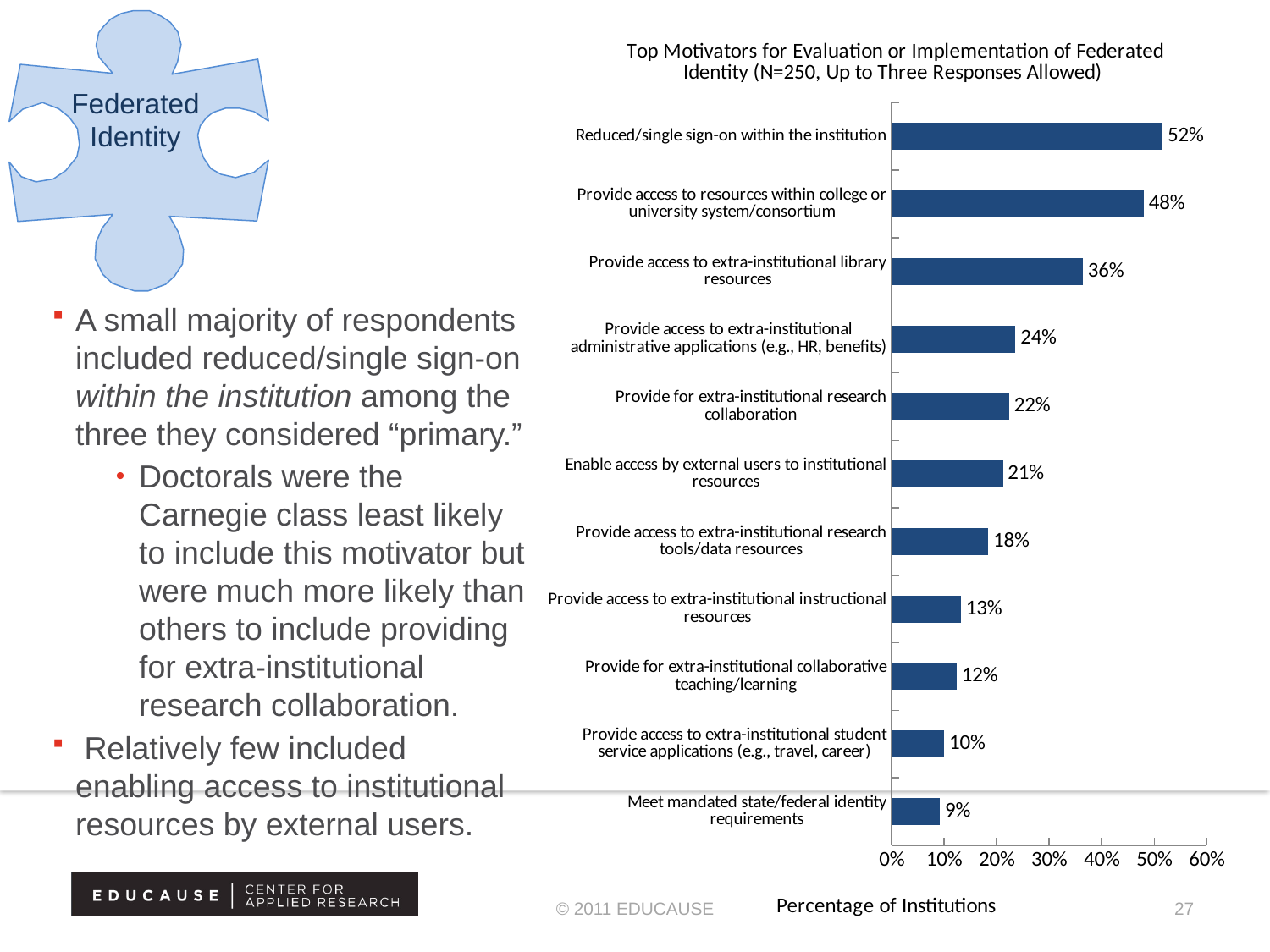
Which motivator has the highest percentage of institutions? Reduced/single sign-on within the institution What is the label on the horizontal axis of the chart? Percentage of Institutions What is the value for 'Provide access to extra-institutional library resources'? 36% Which motivator has the lowest percentage of institutions? Meet mandated state/federal identity requirements What type of chart is used on this slide? Bar chart Is the value for 'Provide access to extra-institutional administrative applications (e.g., HR, benefits)' greater or less than 20%? greater What percentage of institutions cited reduced/single sign-on within the institution as a top motivator? 52% What is the title of the chart? Top Motivators for Evaluation or Implementation of Federated Identity (N=250, Up to Three Responses Allowed) What is the difference in percentage points between 'Reduced/single sign-on within the institution' and 'Provide access to resources within college or university system/consortium'? 4 percentage points How many motivator categories are shown in the chart? 11 Which is larger: the value for 'Provide for extra-institutional research collaboration' or the value for 'Provide access to extra-institutional instructional resources'? Provide for extra-institutional research collaboration What percentage is shown for 'Meet mandated state/federal identity requirements'? 9%